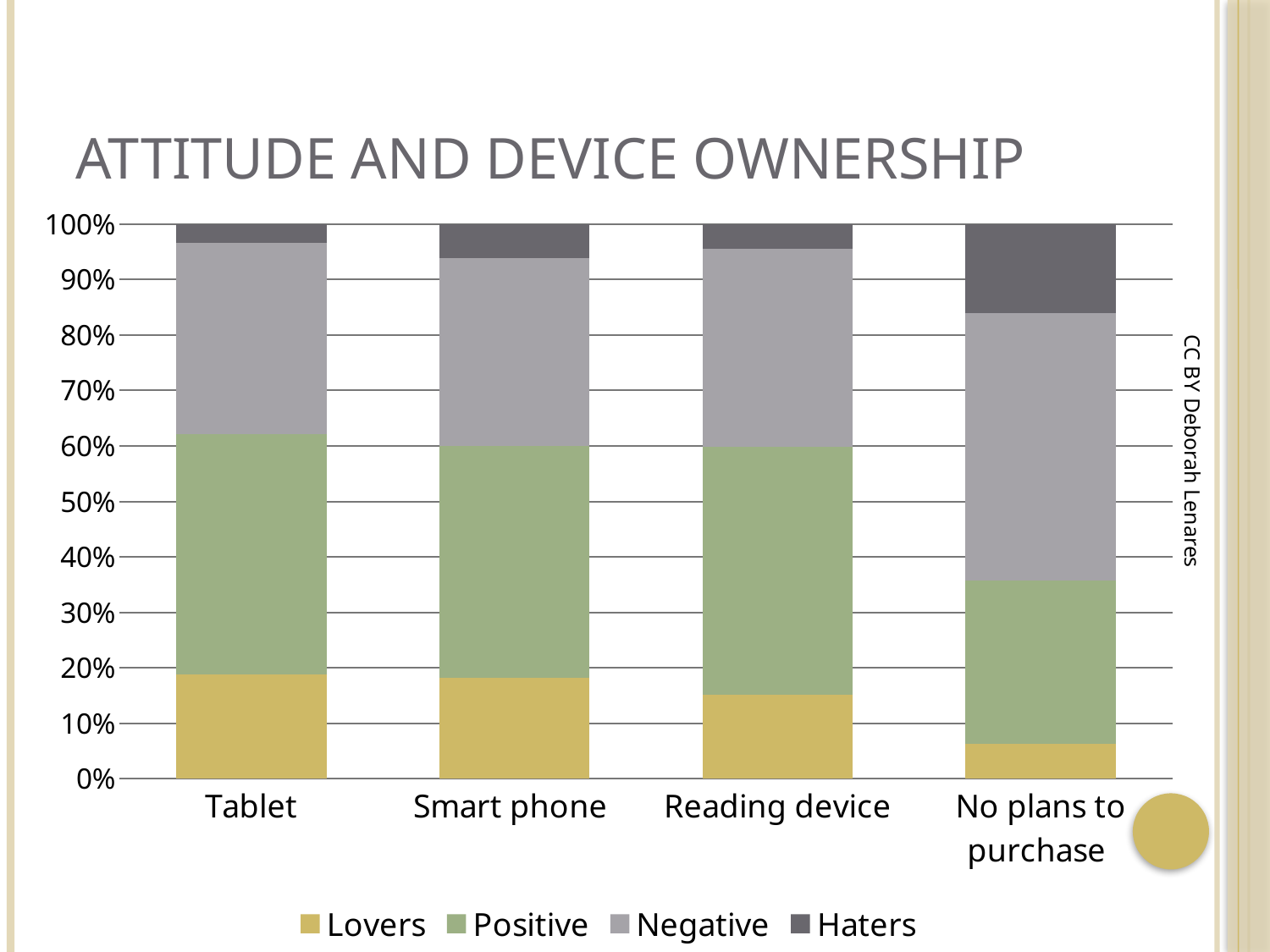
Which category has the smallest Lovers share? No plans to purchase Which series forms the bottom segment of each bar? Lovers How many device categories are shown on the x axis? 4 Is the Lovers share for Tablet greater or less than 10%? greater What kind of chart is shown on the slide? Stacked bar chart What is the title of the chart? ATTITUDE AND DEVICE OWNERSHIP Which category has the largest Negative share? No plans to purchase Is the Haters share for No plans to purchase greater or less than 10%? greater Is the Positive share larger for Reading device or for No plans to purchase? Reading device How many series does the legend list? 4 Is the Lovers share for No plans to purchase greater or less than 10%? less Which category has the largest Haters share? No plans to purchase